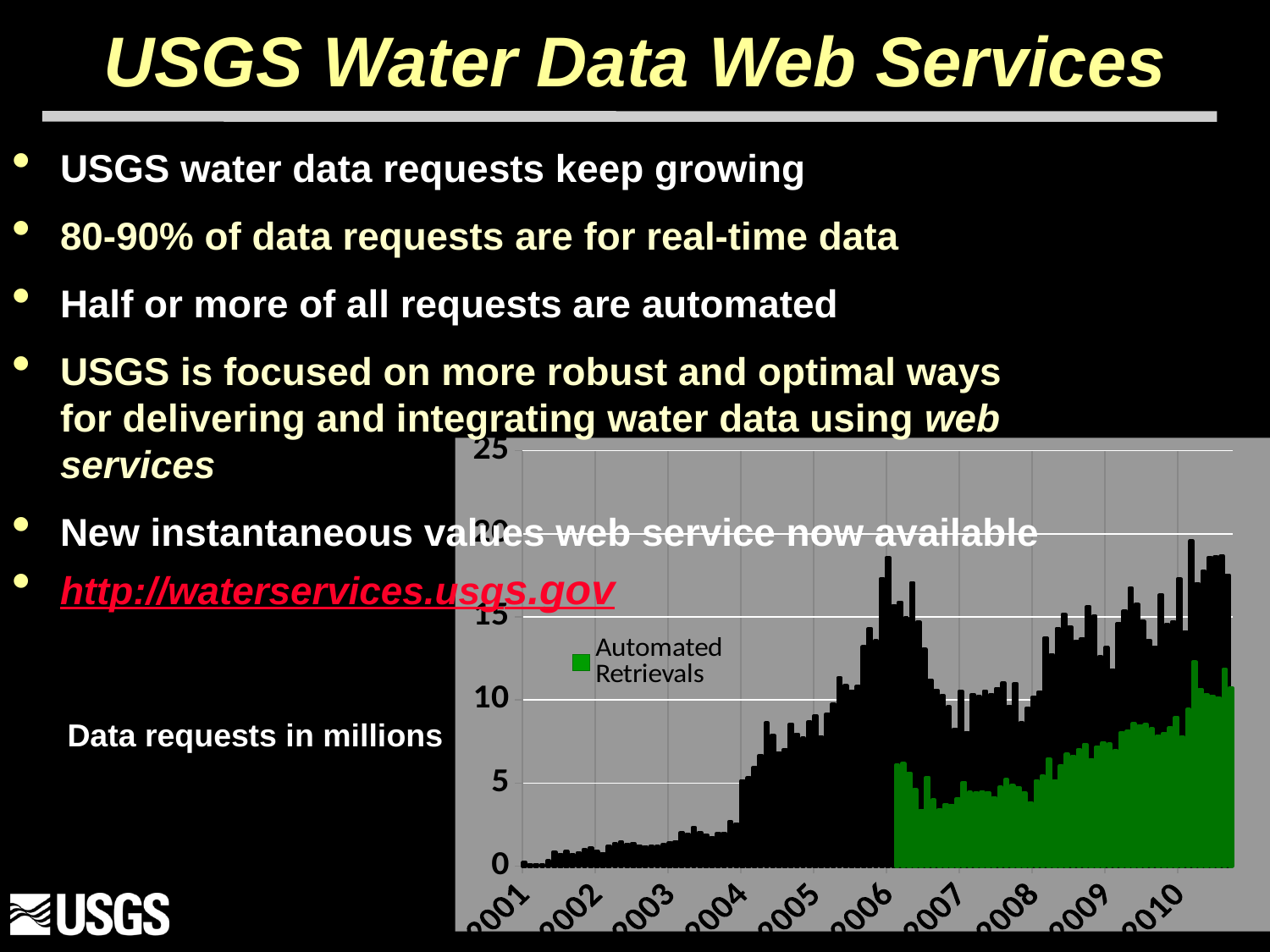
Is the peak value of data requests in 2010 greater or less than 15? greater What is the highest tick value on the y axis of the chart? 25 Which year has higher data requests, 2002 or 2009? 2009 What kind of chart is shown on the slide? bar chart What is the first year shown on the x axis of the chart? 2001 Is the value for Automated Retrievals in 2007 greater or less than 10? less What series does the legend in the chart identify? Automated Retrievals Is the value for data requests in 2001 greater or less than 5? less What is the last year shown on the x axis of the chart? 2010 How many year labels are shown along the x axis of the chart? 10 Do data requests generally rise or fall from 2001 to 2010 in the chart? rise What is the unit of the values plotted in the chart, according to the slide? Data requests in millions